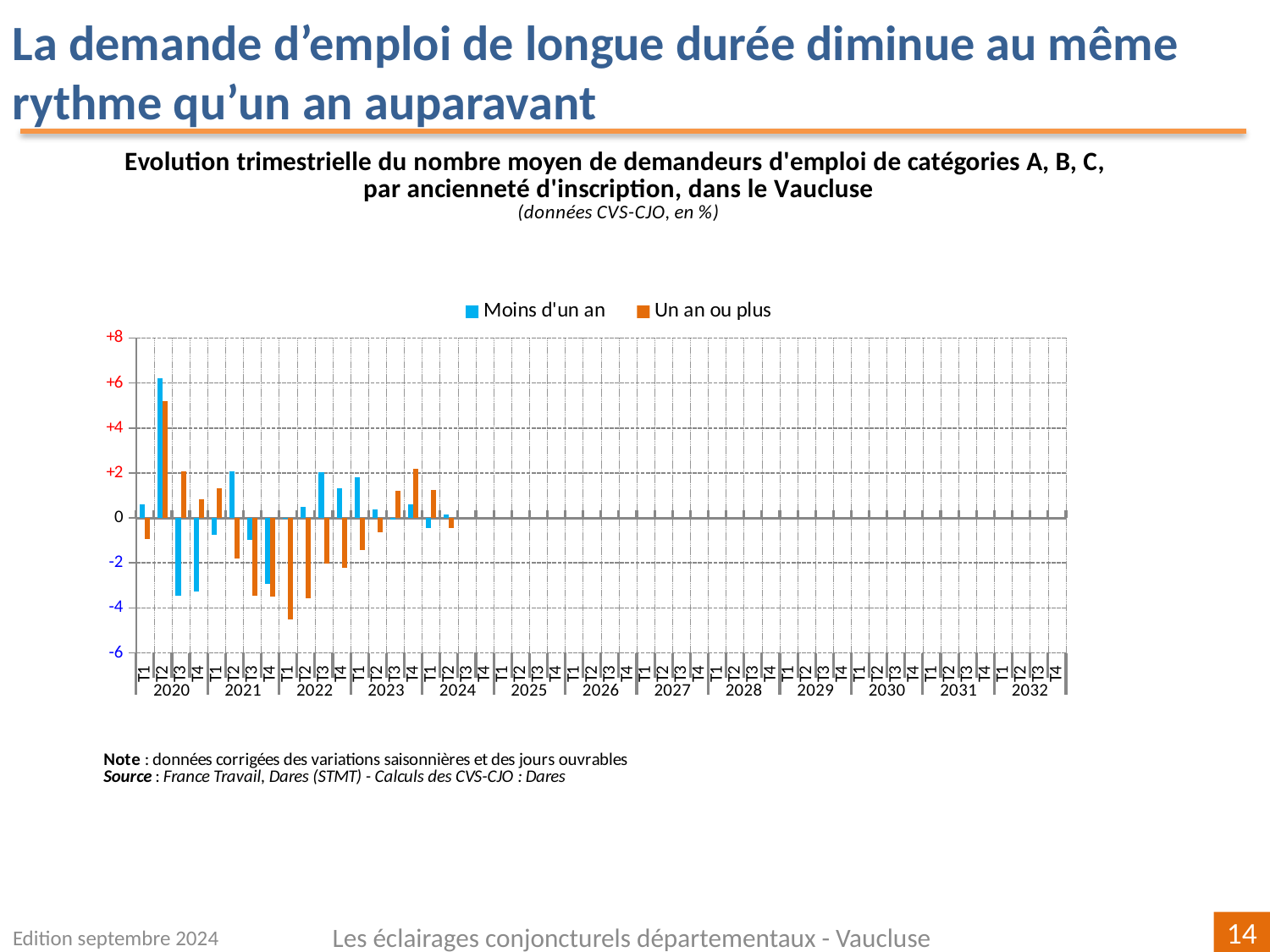
What kind of chart is shown on the slide? Bar chart In what unit are the values of the chart expressed, according to the subtitle? en % In T4 2023, which series has the larger value, 'Moins d'un an' or 'Un an ou plus'? Un an ou plus Is the value for 'Moins d'un an' in T3 2020 greater or less than -2? less Is the value for 'Moins d'un an' in T2 2020 greater or less than +4? greater Is the value for 'Un an ou plus' in T2 2020 greater or less than +4? greater Which quarter has the highest value for the series 'Moins d'un an'? T2 2020 What are the two series named in the chart legend? Moins d'un an; Un an ou plus Which quarter has the lowest value for the series 'Un an ou plus'? T1 2022 How many series does the chart legend list? 2 In T2 2020, which series has the larger value, 'Moins d'un an' or 'Un an ou plus'? Moins d'un an